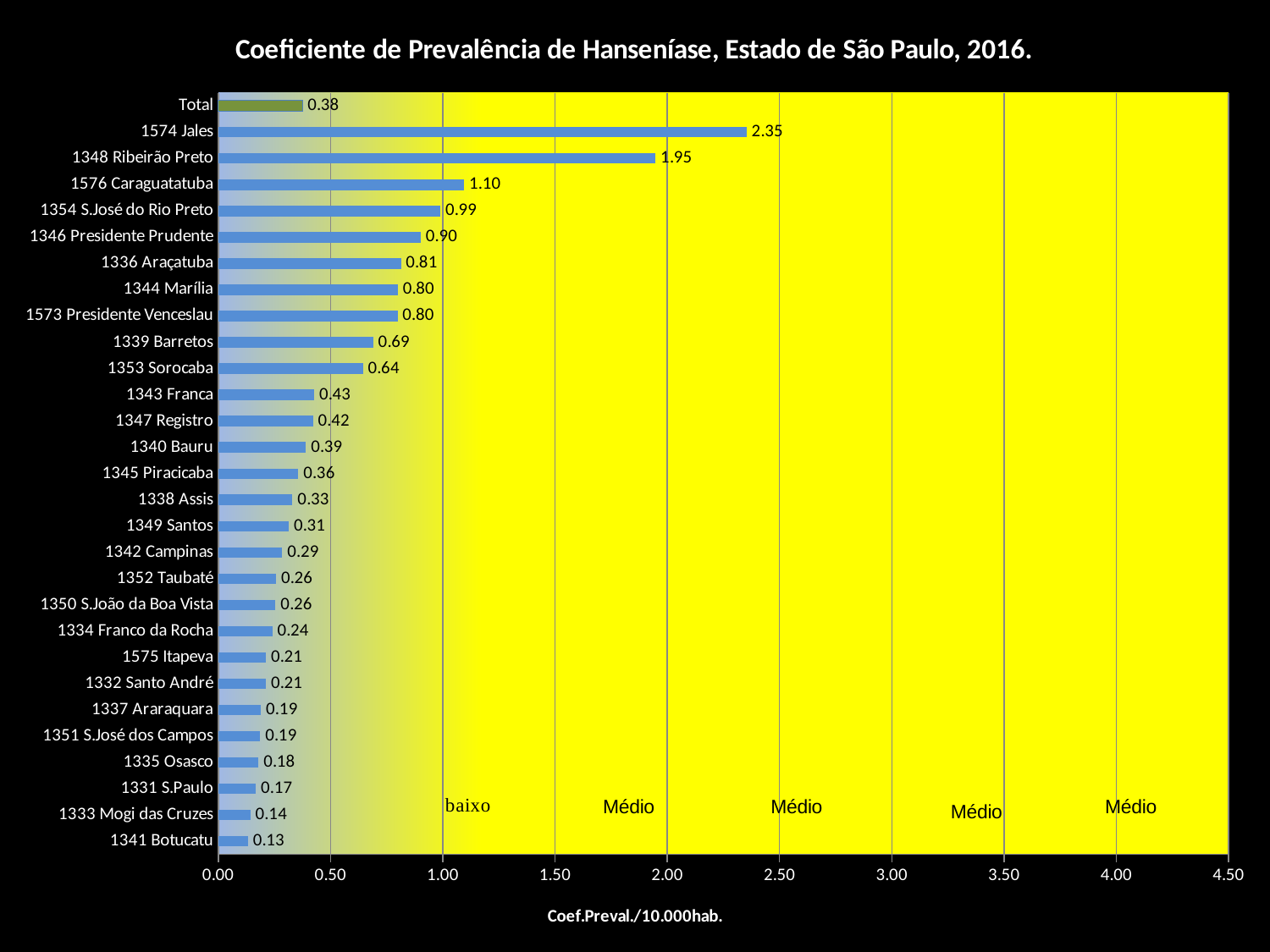
What is the label of the horizontal axis? Coef.Preval./10.000hab. What is the value for 1353 Sorocaba? 0.64 Which region has the highest coefficient? 1574 Jales How many bars are plotted on the chart, including Total? 29 Which region has the lowest coefficient? 1341 Botucatu Is the value for 1348 Ribeirão Preto greater or less than 1.50? greater What is the value for 1574 Jales? 2.35 What kind of chart is shown on the slide? Bar chart Which has a larger value, 1576 Caraguatatuba or 1354 S.José do Rio Preto? 1576 Caraguatatuba What is the value for 1331 S.Paulo? 0.17 What is the value for the Total bar? 0.38 What is the difference between the values for 1574 Jales and 1348 Ribeirão Preto? 0.40